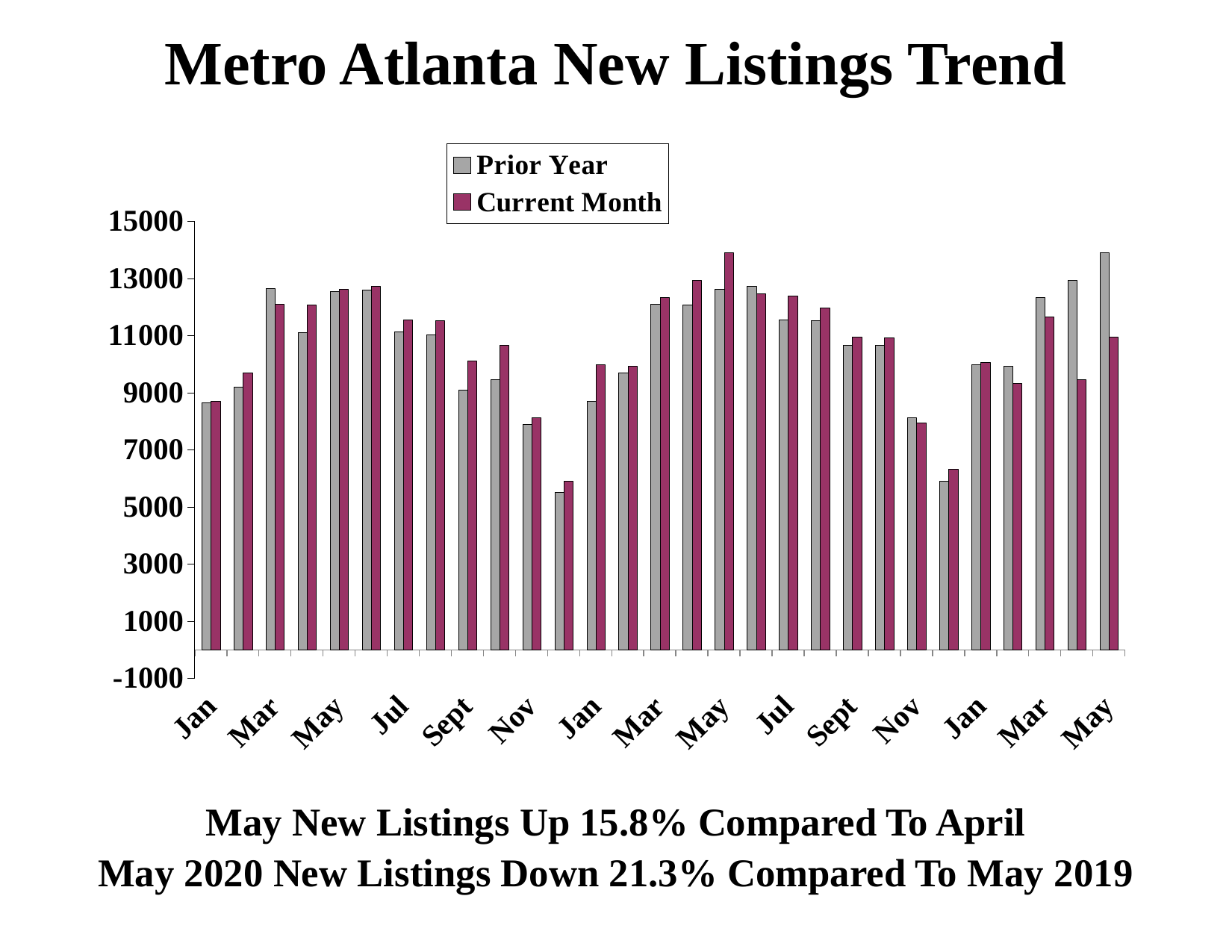
Which month has the highest Current Month bar? May (the middle May) How many month labels are printed along the x axis? 15 Do the Prior Year values rise or fall from the first Jan to the first Mar on the x axis? rise What kind of chart is shown on the slide? bar chart How many series does the legend list? 2 What are the two series named in the legend? Prior Year and Current Month Is the Prior Year value for the last May on the x axis greater or less than 13000? greater For the last May on the x axis, which is larger: the Prior Year bar or the Current Month bar? Prior Year Is the Current Month value for the first Jan on the x axis greater or less than 9000? less Is the Prior Year value for the first Dec (the bar just before the second Jan) greater or less than 7000? less What is the title of the chart? Metro Atlanta New Listings Trend